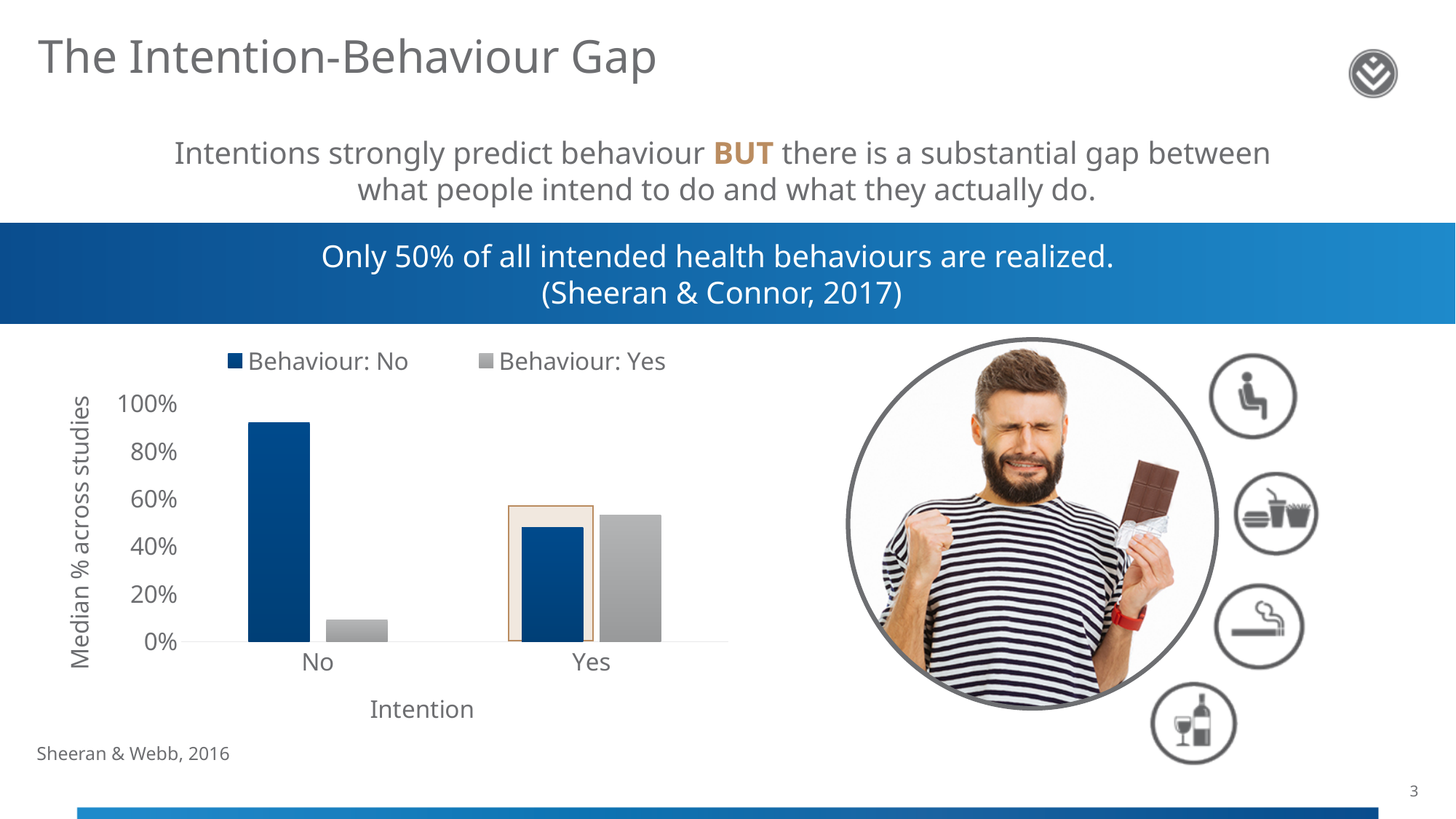
How many categories are shown on the x axis of the chart? 2 For the Intention No category, which is larger: Behaviour: No or Behaviour: Yes? Behaviour: No Is the Behaviour: Yes value for Intention Yes greater or less than 40%? greater Which series has the tallest bar in the chart, and for which intention category? Behaviour: No, for Intention No What kind of chart is shown on the slide? Bar chart What is the label of the chart's y axis? Median % across studies Is the Behaviour: No value for Intention No greater or less than 80%? greater What is the label of the chart's x axis? Intention Which bar is the lowest in the chart? Behaviour: Yes for Intention No How many series does the chart legend list? 2 Is the Behaviour: No value for Intention Yes greater or less than 60%? less